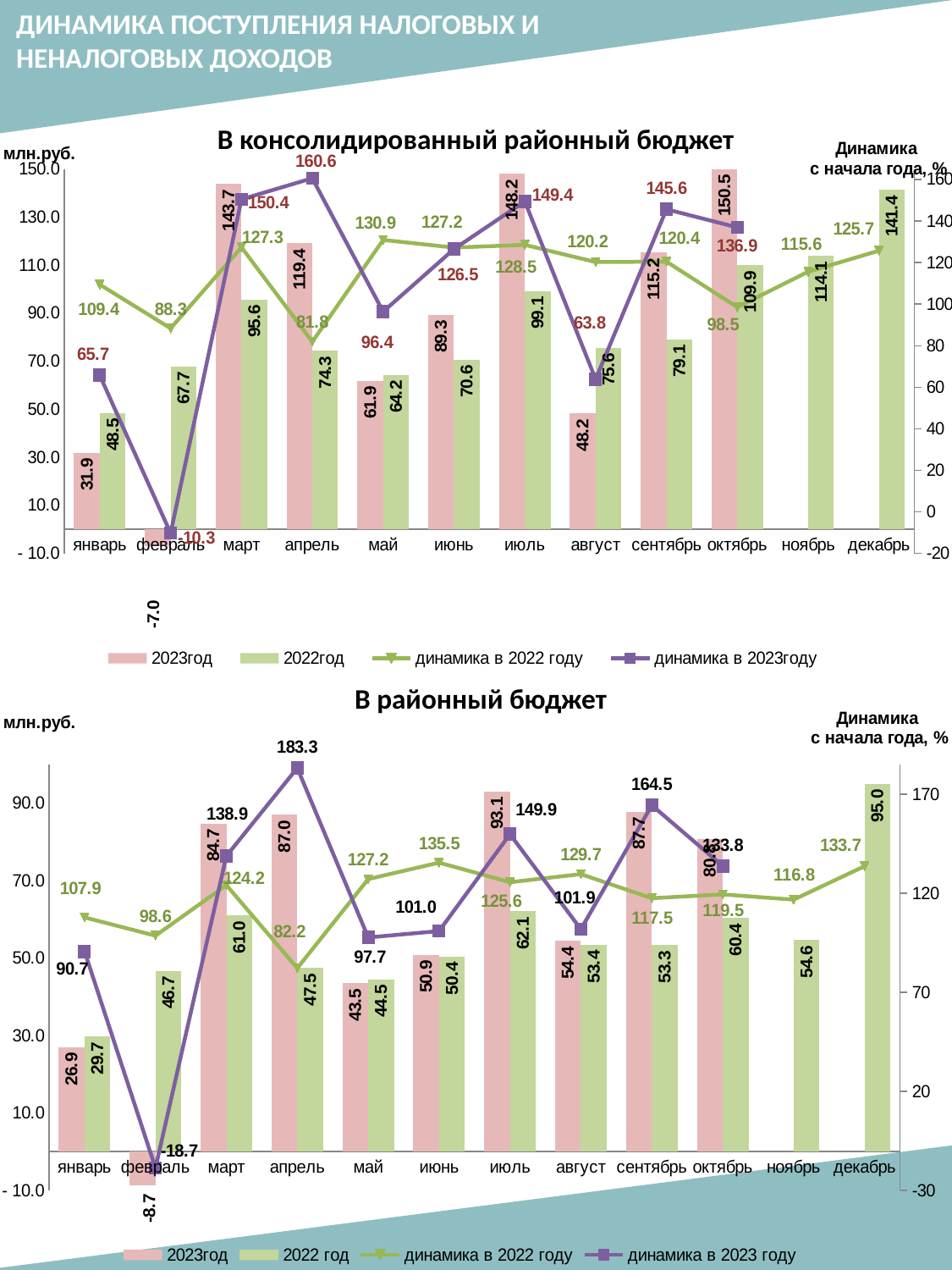
In the chart 'В консолидированный районный бюджет', what is the value of 'динамика в 2023году' for апрель? 160.6 How many series does the legend of the chart 'В консолидированный районный бюджет' list? 4 In the chart 'В районный бюджет', what is the difference between the 2023год and 2022 год values for январь? 2.8 How many months are shown on the x axis of the chart 'В районный бюджет'? 12 In the chart 'В консолидированный районный бюджет', which month has the lowest 2023год value? февраль In the chart 'В консолидированный районный бюджет', what is the difference between the 2023год and 2022год values for март? 48.1 In the chart 'В районный бюджет', what is the 2022 год value for декабрь? 95.0 In the chart 'В районный бюджет', what is the value of 'динамика в 2023 году' for апрель? 183.3 In the chart 'В районный бюджет', which month has the highest 2023год value? июль In the chart 'В консолидированный районный бюджет', what is the 2023год value for октябрь? 150.5 In the chart 'В консолидированный районный бюджет', what is the 2022год value for декабрь? 141.4 In the chart 'В консолидированный районный бюджет', which is larger for май: the 2023год value or the 2022год value? 2022год